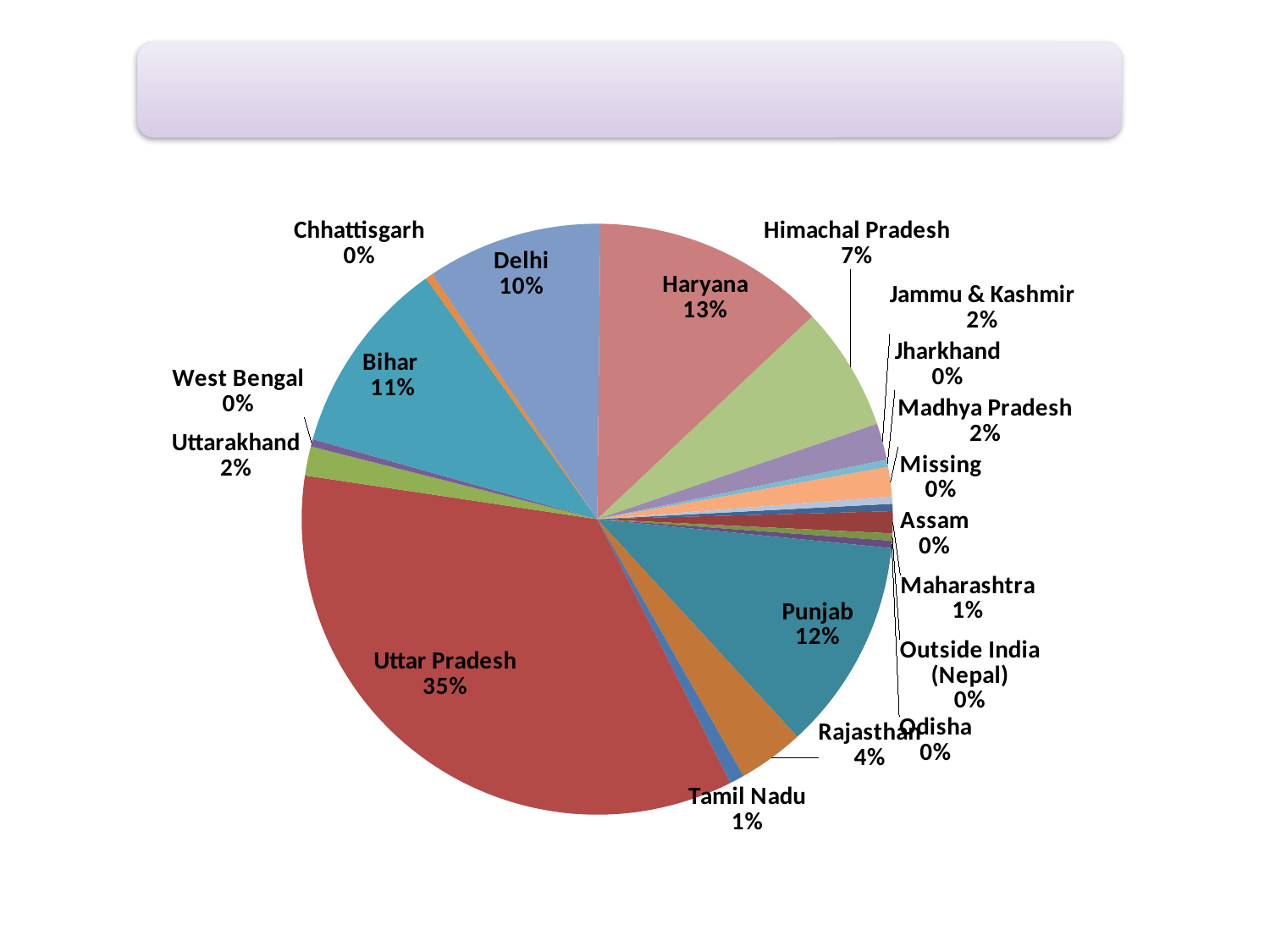
What is the value shown for Haryana? 13% What share of the pie does Uttar Pradesh have? 35% What is the value shown for Punjab? 12% What is the difference between the shares of Uttar Pradesh and Haryana? 22% What kind of chart is shown on the slide? pie chart How many categories are labelled on the pie chart? 19 What is the value shown for Himachal Pradesh? 7% Which is larger, the share for Bihar or the share for Himachal Pradesh? Bihar Which category has the largest slice of the pie? Uttar Pradesh What is the value shown for Bihar? 11% What is the value shown for Rajasthan? 4% What is the difference between the shares of Punjab and Delhi? 2%